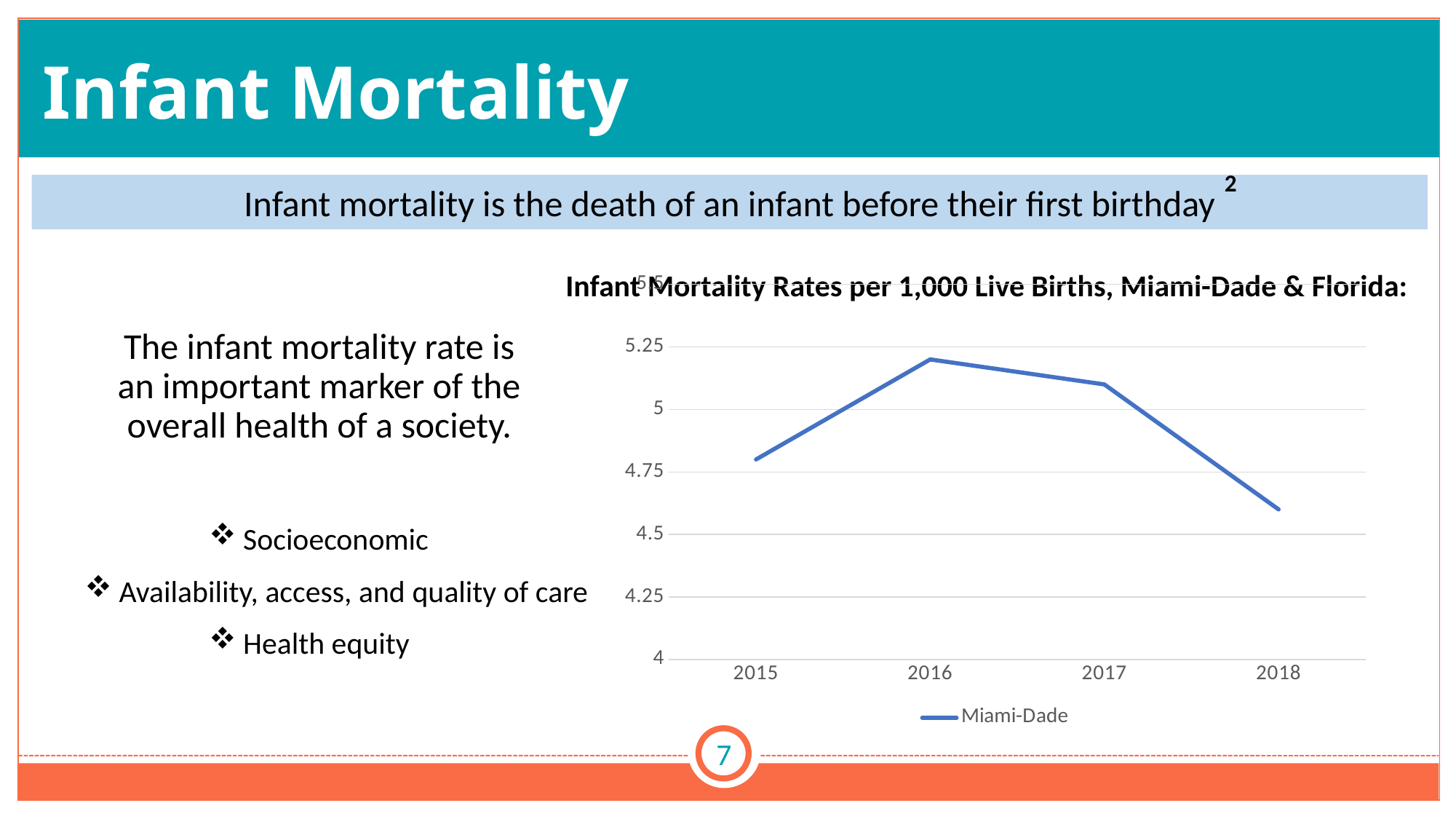
Which year has a higher Miami-Dade infant mortality rate, 2015 or 2016? 2016 How many years are plotted on the x axis of the chart? 4 Does the Miami-Dade infant mortality rate rise or fall from 2017 to 2018? fall Is the Miami-Dade value for 2016 greater or less than 5? greater What series name is shown in the chart legend? Miami-Dade Is the Miami-Dade value for 2018 greater or less than 4.75? less Is the Miami-Dade value for 2018 greater or less than 4.5? greater In which year is the Miami-Dade infant mortality rate lowest? 2018 What kind of chart is shown on the slide? line chart In which year is the Miami-Dade infant mortality rate highest? 2016 How many series does the chart legend list? 1